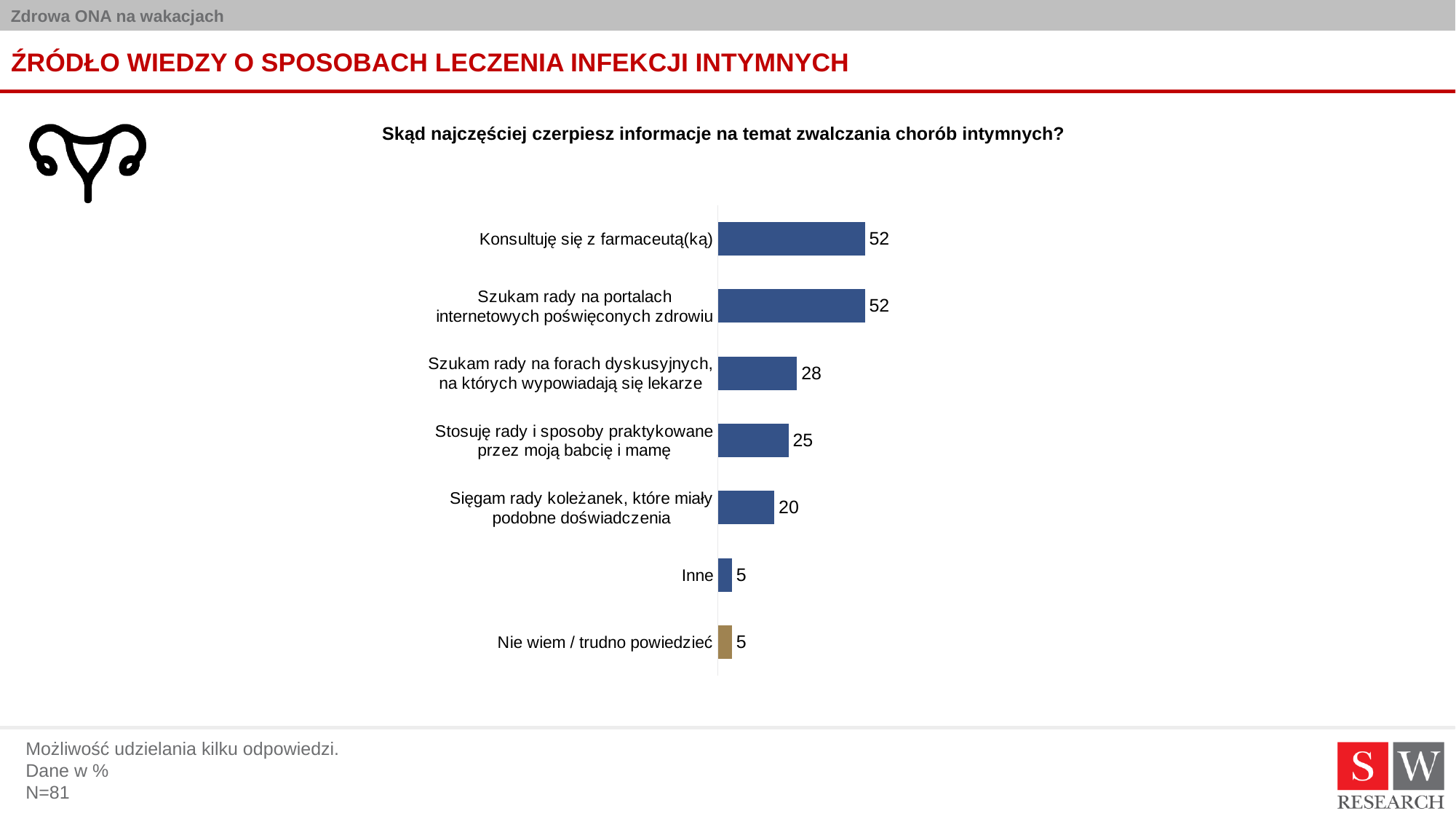
Which category's bar is shown in a different colour from the others? Nie wiem / trudno powiedzieć How many categories are shown in the chart? 7 What is the difference between the values for "Szukam rady na portalach internetowych poświęconych zdrowiu" and "Szukam rady na forach dyskusyjnych, na których wypowiadają się lekarze"? 24 What value is shown for "Stosuję rady i sposoby praktykowane przez moją babcię i mamę"? 25 What value is shown for "Sięgam rady koleżanek, które miały podobne doświadczenia"? 20 What is the difference between the values for "Konsultuję się z farmaceutą(ką)" and "Inne"? 47 What kind of chart is shown on the slide? Bar chart Which is larger: the value for "Stosuję rady i sposoby praktykowane przez moją babcię i mamę" or for "Sięgam rady koleżanek, które miały podobne doświadczenia"? Stosuję rady i sposoby praktykowane przez moją babcię i mamę What value is shown for "Szukam rady na forach dyskusyjnych, na których wypowiadają się lekarze"? 28 What value is shown for "Konsultuję się z farmaceutą(ką)"? 52 What question is shown above the chart? Skąd najczęściej czerpiesz informacje na temat zwalczania chorób intymnych? What value is shown for "Inne"? 5